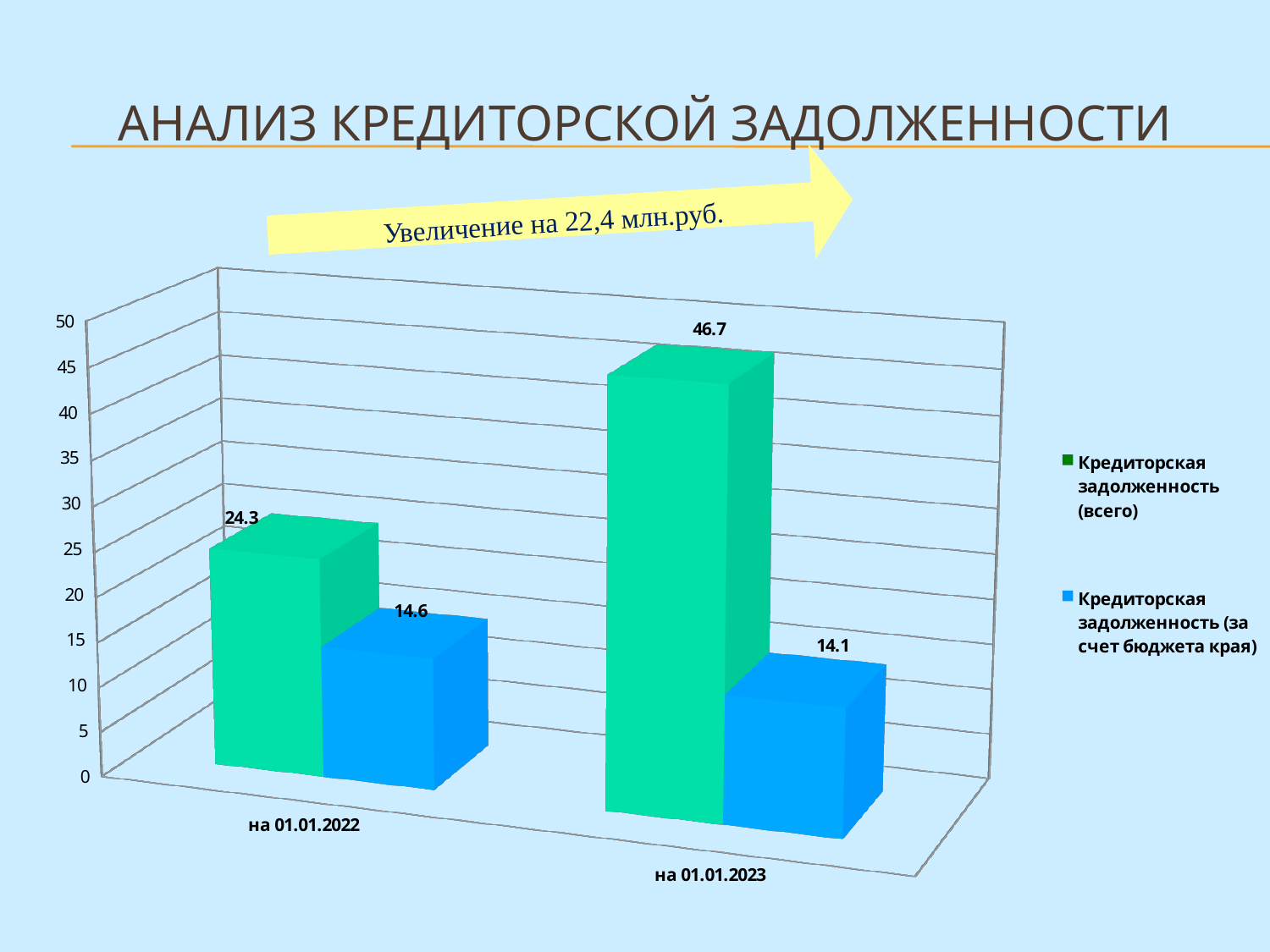
What is the value of Кредиторская задолженность (всего) for на 01.01.2023? 46.7 What is the difference between Кредиторская задолженность (всего) and Кредиторская задолженность (за счет бюджета края) for на 01.01.2023? 32.6 What is the value of Кредиторская задолженность (за счет бюджета края) for на 01.01.2022? 14.6 What is the value of Кредиторская задолженность (за счет бюджета края) for на 01.01.2023? 14.1 What is the difference between Кредиторская задолженность (всего) on на 01.01.2023 and на 01.01.2022? 22.4 Which is larger: Кредиторская задолженность (за счет бюджета края) for на 01.01.2022 or for на 01.01.2023? на 01.01.2022 How many categories are shown on the x axis? 2 What is the value of Кредиторская задолженность (всего) for на 01.01.2022? 24.3 Which category has the highest value for Кредиторская задолженность (всего)? на 01.01.2023 What kind of chart is shown on the slide? bar chart How many series does the legend list? 2 Does Кредиторская задолженность (всего) rise or fall from на 01.01.2022 to на 01.01.2023? rise